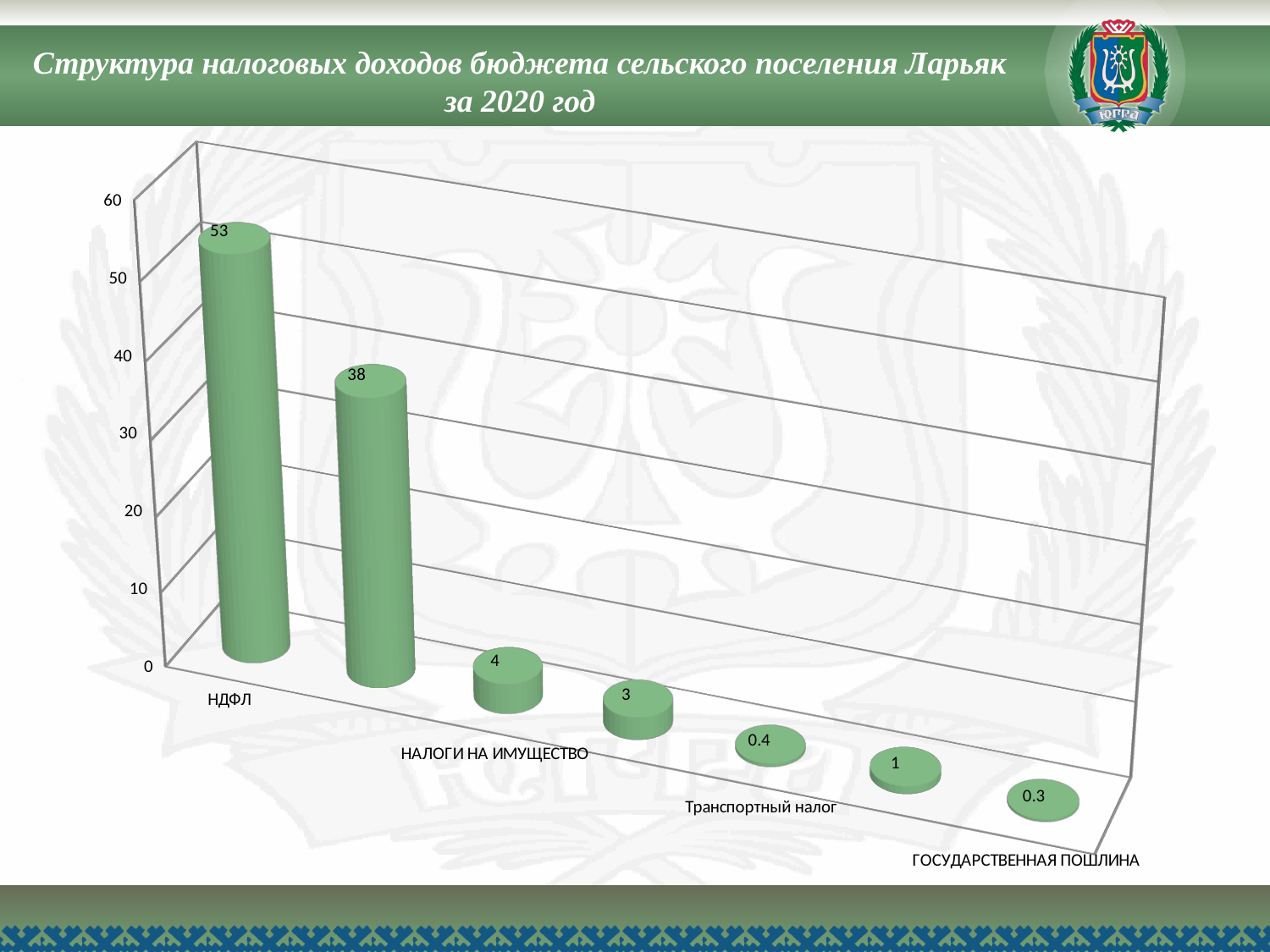
Which is larger, the value for НДФЛ or the value of the second bar? НДФЛ How many bars are plotted on the chart? 7 What is the smallest value shown on the chart? 0.3 What is the highest value printed on the vertical axis? 60 What is the value of the bar for НДФЛ? 53 What kind of chart is shown on the slide? bar chart What is the value of the last bar on the right, labelled ГОСУДАРСТВЕННАЯ ПОШЛИНА? 0.3 What year does the chart title refer to? 2020 Is the value for НДФЛ greater or less than 50? greater Which category has the highest value? НДФЛ What is the value of the second bar from the left? 38 What is the difference between the first bar (53) and the second bar (38)? 15